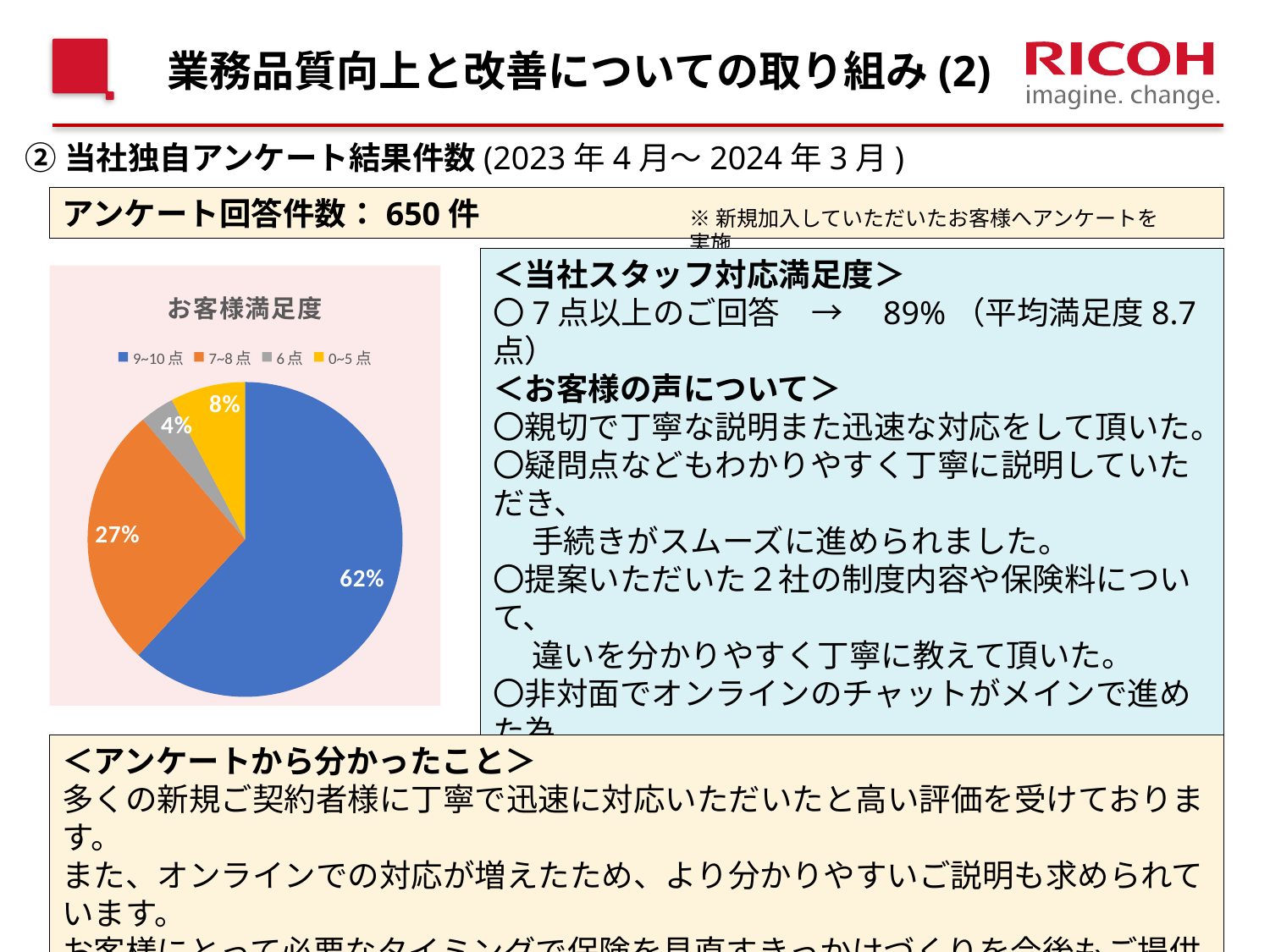
What is the difference in percentage points between the 9~10点 slice and the 7~8点 slice? 35 What share of the pie is the 0~5点 slice? 8% How many slices does the pie chart have? 4 What share of the pie is the 6点 slice? 4% What share of the pie is the 7~8点 slice? 27% Which category has the largest slice of the pie? 9~10点 Which slice is larger, 0~5点 or 6点? 0~5点 How many entries does the chart's legend list? 4 What kind of chart is shown on the slide? pie chart What is the title of the chart? お客様満足度 Which category has the smallest slice of the pie? 6点